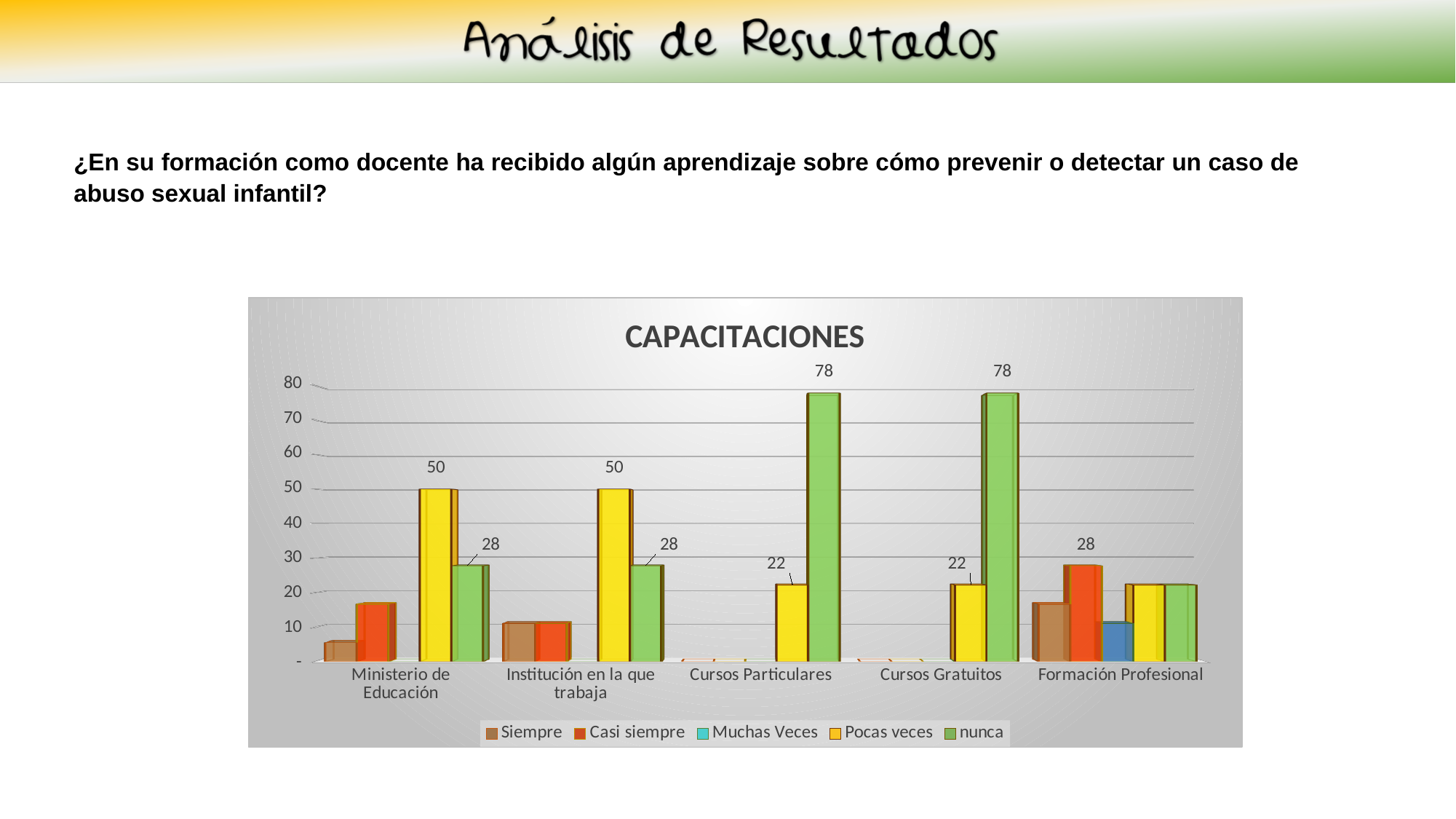
Is the value of Siempre for Ministerio de Educación greater or less than 10? less What is the value of Pocas veces for Cursos Gratuitos? 22 How many series does the legend list? 5 What is the value of Pocas veces for Ministerio de Educación? 50 What is the difference between Pocas veces and nunca for Institución en la que trabaja? 22 For Ministerio de Educación, which is larger: Pocas veces or nunca? Pocas veces What is the value of nunca for Cursos Particulares? 78 What is the value of Casi siempre for Formación Profesional? 28 How many categories are shown on the x axis? 5 What is the difference between nunca and Pocas veces for Cursos Gratuitos? 56 Which series has the highest value for Cursos Particulares? nunca What type of chart is shown on the slide? bar chart